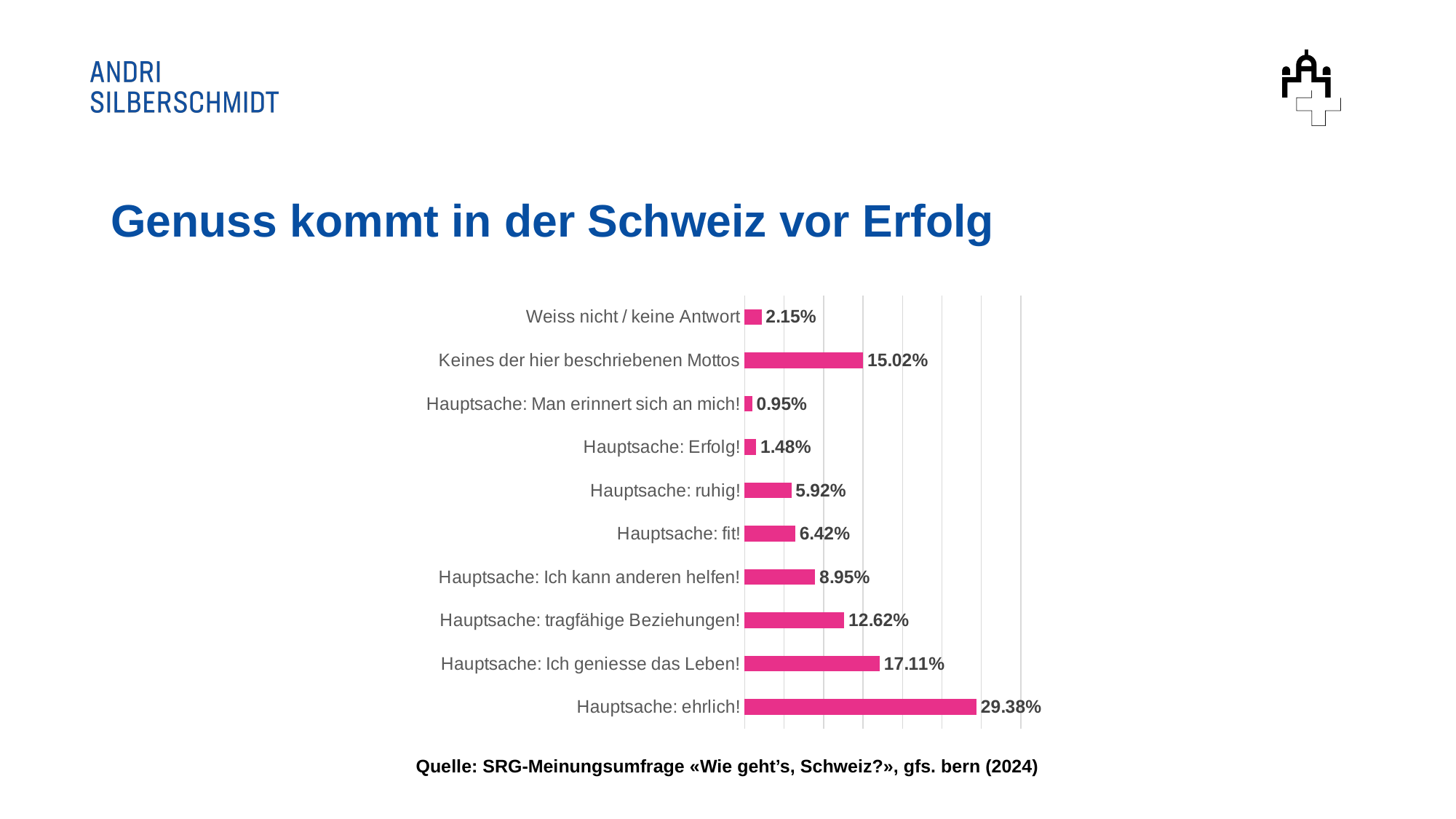
What value is shown for "Hauptsache: Erfolg!"? 1.48% What value is shown for "Hauptsache: Ich kann anderen helfen!"? 8.95% What is the difference between "Hauptsache: Ich geniesse das Leben!" and "Hauptsache: Erfolg!"? 15.63% Which is larger, "Hauptsache: tragfähige Beziehungen!" or "Keines der hier beschriebenen Mottos"? Keines der hier beschriebenen Mottos Which category has the highest value? Hauptsache: ehrlich! What percentage is shown for "Hauptsache: ehrlich!"? 29.38% What kind of chart is shown on the slide? Bar chart What percentage is shown for "Keines der hier beschriebenen Mottos"? 15.02% What is the difference between "Hauptsache: ehrlich!" and "Hauptsache: Ich geniesse das Leben!"? 12.27% Which category has the lowest value? Hauptsache: Man erinnert sich an mich! How many categories are shown in the chart? 10 Which is larger, "Hauptsache: fit!" or "Hauptsache: ruhig!"? Hauptsache: fit!